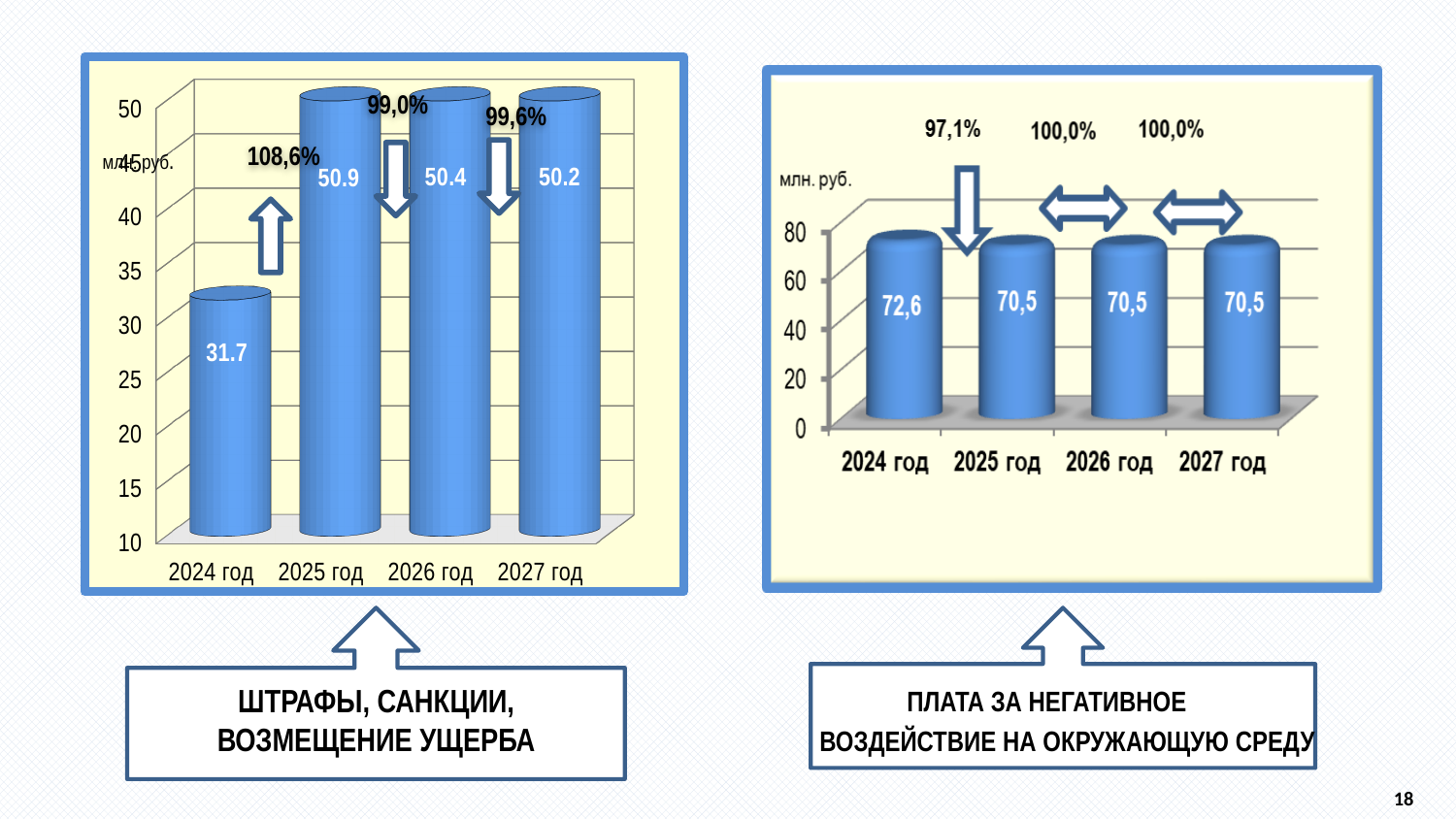
In the left chart (ШТРАФЫ, САНКЦИИ, ВОЗМЕЩЕНИЕ УЩЕРБА), what is the value for 2024 год? 31.7 In the right chart (ПЛАТА ЗА НЕГАТИВНОЕ ВОЗДЕЙСТВИЕ НА ОКРУЖАЮЩУЮ СРЕДУ), what is the value for 2024 год? 72,6 In the left chart (ШТРАФЫ, САНКЦИИ, ВОЗМЕЩЕНИЕ УЩЕРБА), what percentage label is shown above the arrow between 2024 год and 2025 год? 108,6% In the left chart (ШТРАФЫ, САНКЦИИ, ВОЗМЕЩЕНИЕ УЩЕРБА), which year has the highest value? 2025 год In the right chart (ПЛАТА ЗА НЕГАТИВНОЕ ВОЗДЕЙСТВИЕ НА ОКРУЖАЮЩУЮ СРЕДУ), what is the difference between the values for 2024 год and 2025 год? 2,1 How many bars are shown in the right chart (ПЛАТА ЗА НЕГАТИВНОЕ ВОЗДЕЙСТВИЕ НА ОКРУЖАЮЩУЮ СРЕДУ)? 4 In the left chart (ШТРАФЫ, САНКЦИИ, ВОЗМЕЩЕНИЕ УЩЕРБА), what is the value for 2026 год? 50.4 In the right chart (ПЛАТА ЗА НЕГАТИВНОЕ ВОЗДЕЙСТВИЕ НА ОКРУЖАЮЩУЮ СРЕДУ), which year has the highest value? 2024 год In the left chart (ШТРАФЫ, САНКЦИИ, ВОЗМЕЩЕНИЕ УЩЕРБА), what is the difference between the values for 2025 год and 2024 год? 19.2 In the right chart (ПЛАТА ЗА НЕГАТИВНОЕ ВОЗДЕЙСТВИЕ НА ОКРУЖАЮЩУЮ СРЕДУ), what is the value for 2027 год? 70,5 In the left chart (ШТРАФЫ, САНКЦИИ, ВОЗМЕЩЕНИЕ УЩЕРБА), which year has the lowest value? 2024 год What type of chart is the left chart (ШТРАФЫ, САНКЦИИ, ВОЗМЕЩЕНИЕ УЩЕРБА)? Bar chart